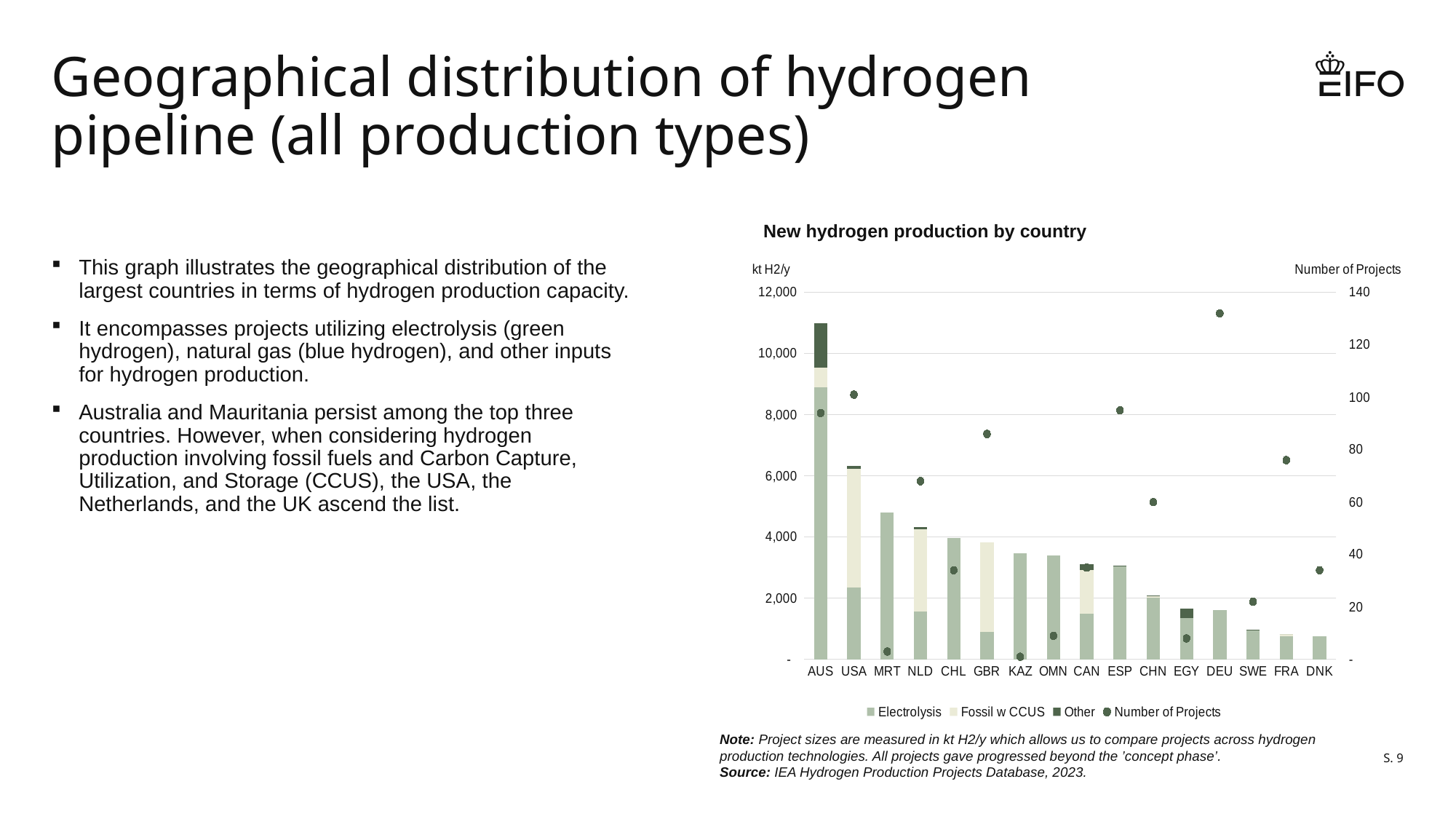
What is the title of the chart? New hydrogen production by country Which has the larger total production bar, MRT or NLD? MRT Is the total production bar for MRT greater or less than 6,000 kt H2/y? less Which country has the highest total hydrogen production bar? AUS Which country has the highest number of projects? DEU Is the total production bar for AUS greater or less than 10,000 kt H2/y? greater What kind of chart is used to show production by country? stacked bar chart Is the total production bar for DNK greater or less than 2,000 kt H2/y? less How many countries are shown on the x axis of the chart? 16 Do the total production bars generally rise or fall from left to right across the countries? fall How many series does the chart legend list? 4